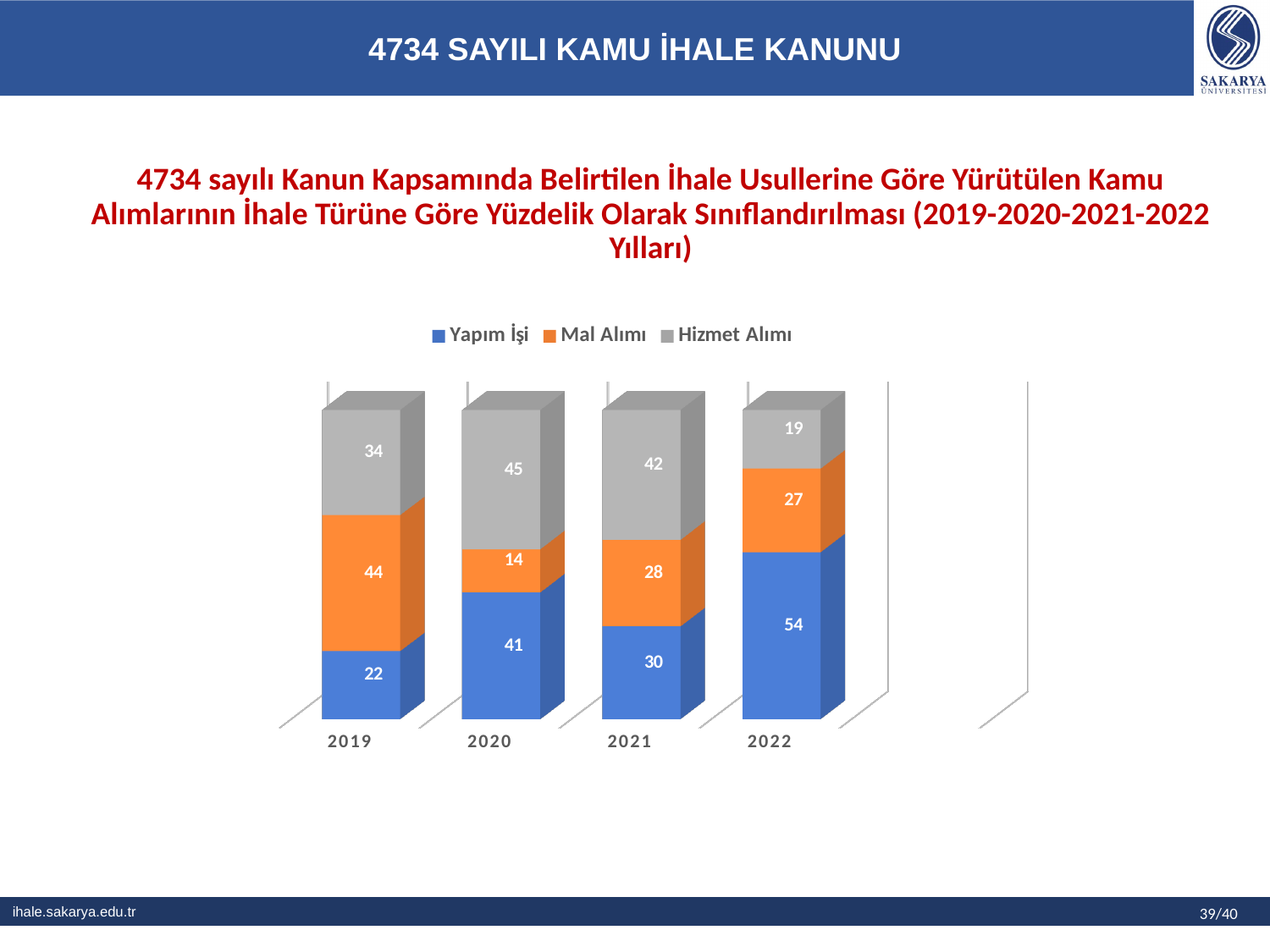
What is the value for Yapım İşi in 2019? 22 How many series does the legend list? 3 How many years are shown on the x axis? 4 What is the total of the stacked bar for 2020? 100 Which is larger in 2021: Yapım İşi or Mal Alımı? Yapım İşi What is the difference between the Mal Alımı values for 2019 and 2020? 30 In which year is the Yapım İşi value highest? 2022 What is the value for Hizmet Alımı in 2021? 42 What is the value for Mal Alımı in 2020? 14 What kind of chart is shown on the slide? Stacked bar chart In which year is the Hizmet Alımı value lowest? 2022 What is the value for Yapım İşi in 2022? 54